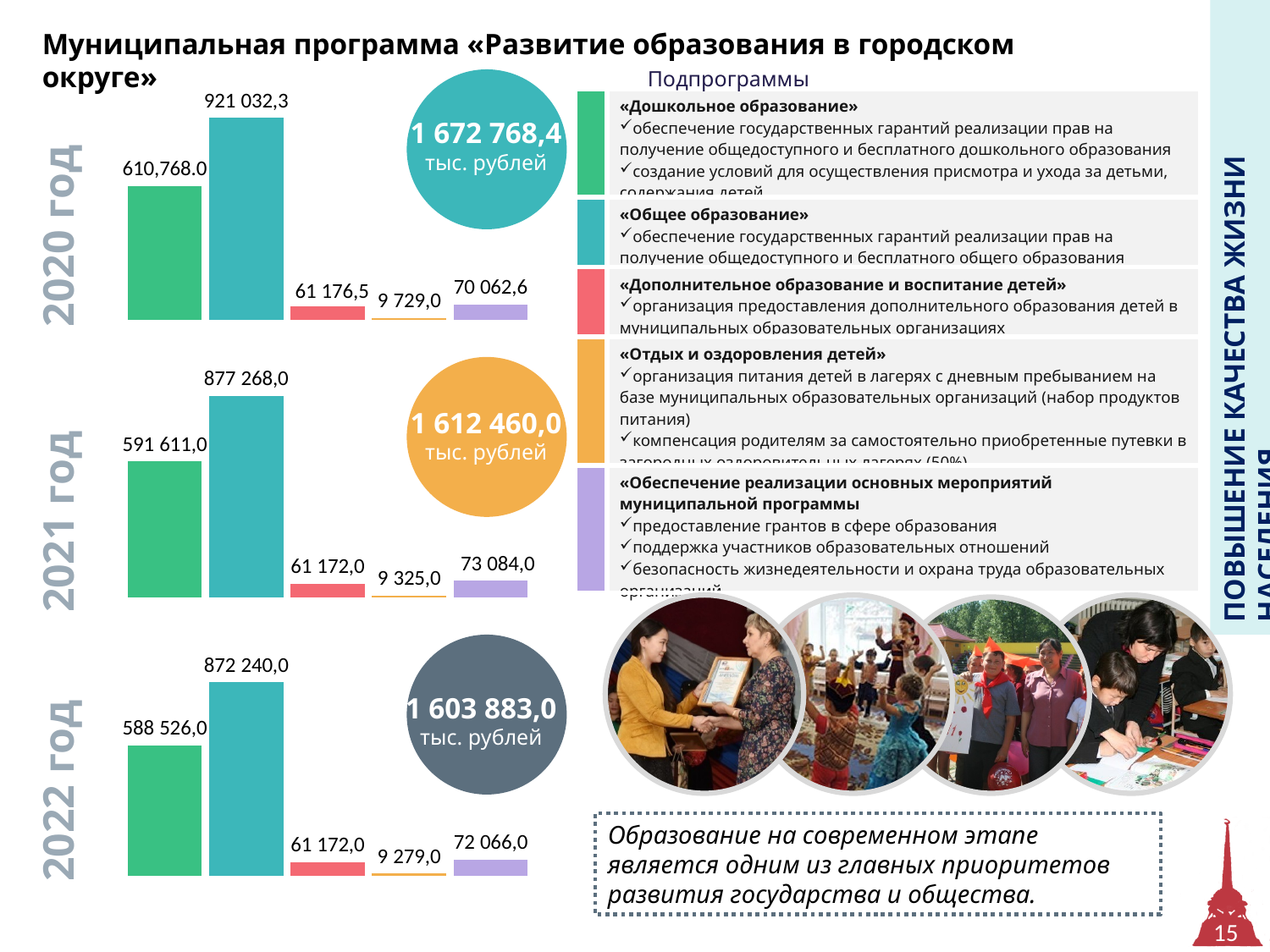
In the 2020 год chart, which is larger: the red bar (61 176,5) or the purple bar (70 062,6)? the purple bar (70 062,6) Do the total programme amounts shown in the circles rise or fall from 2020 to 2022? fall In the 2022 год chart, what is the value of the orange bar (Отдых и оздоровления детей)? 9 279,0 In the 2021 год chart, what is the difference between the teal bar (877 268,0) and the green bar (591 611,0)? 285 657,0 In the 2021 год chart, what is the value of the green bar (Дошкольное образование)? 591 611,0 In the 2022 год chart, what is the difference between the purple bar (72 066,0) and the red bar (61 172,0)? 10 894,0 In the 2022 год chart, which subprogram has the lowest value? Отдых и оздоровления детей (orange bar, 9 279,0) In the 2020 год chart, what is the value of the purple bar (Обеспечение реализации основных мероприятий)? 70 062,6 In the 2021 год chart, which subprogram has the highest value? Общее образование (teal bar, 877 268,0) How many bars are shown in the 2022 год chart? 5 In the 2020 год chart, what is the value of the tallest (teal) bar? 921 032,3 What type of chart is used for each year on the slide? bar chart